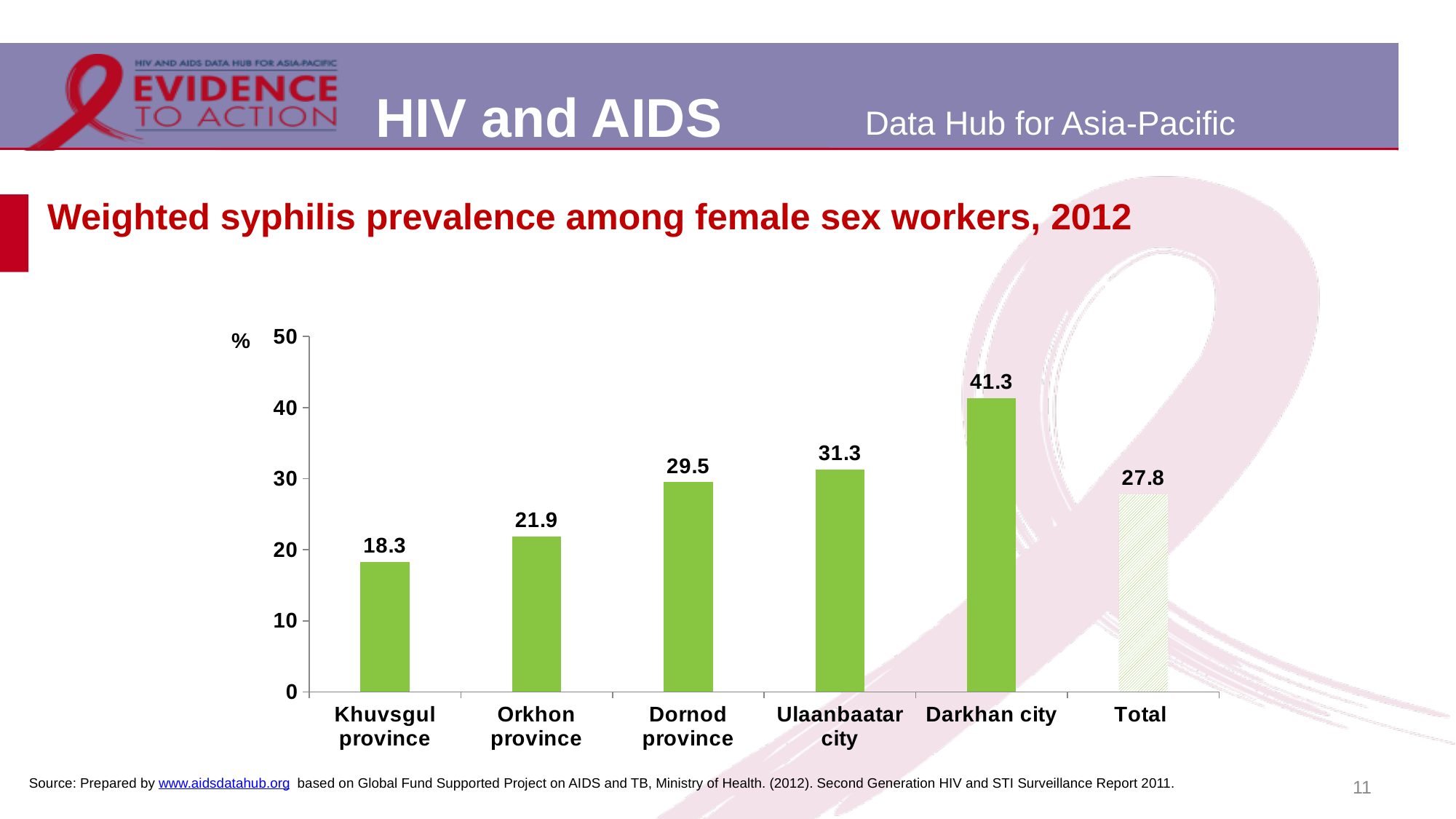
What kind of chart is shown on the slide? bar chart Is the value for Orkhon province greater or less than 30? less Which category has the lowest syphilis prevalence? Khuvsgul province How many categories are shown on the x axis? 6 What is the value shown for Khuvsgul province? 18.3 What is the title of the chart? Weighted syphilis prevalence among female sex workers, 2012 What is the difference between the values for Darkhan city and Ulaanbaatar city? 10.0 What is the difference between the values for Dornod province and Orkhon province? 7.6 Which category has the highest syphilis prevalence? Darkhan city What is the weighted syphilis prevalence among female sex workers in Darkhan city? 41.3 What is the value shown for the Total bar? 27.8 Which is larger, the value for Ulaanbaatar city or the value for Dornod province? Ulaanbaatar city